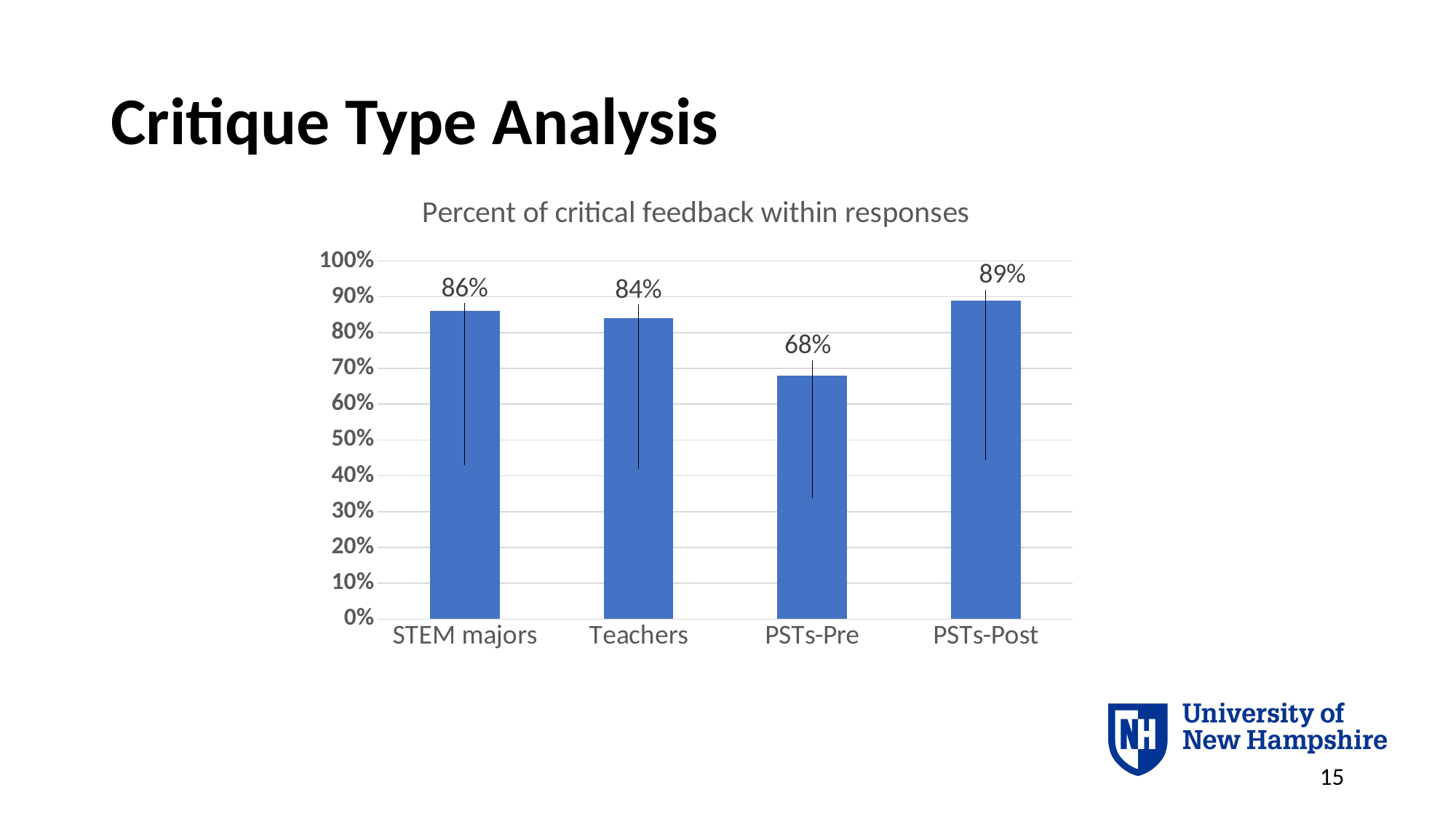
Which is larger, the value for STEM majors or the value for PSTs-Pre? STEM majors Is the value for PSTs-Pre greater or less than 70%? less Which category has the lowest percent of critical feedback? PSTs-Pre What is the value for PSTs-Pre? 68% What is the title of the chart? Percent of critical feedback within responses Which category has the highest percent of critical feedback? PSTs-Post What is the value for STEM majors? 86% How many categories are shown on the x axis? 4 What is the difference between the values for PSTs-Post and PSTs-Pre? 21% What is the value for Teachers? 84% What kind of chart is shown on the slide? bar chart What is the value for PSTs-Post? 89%